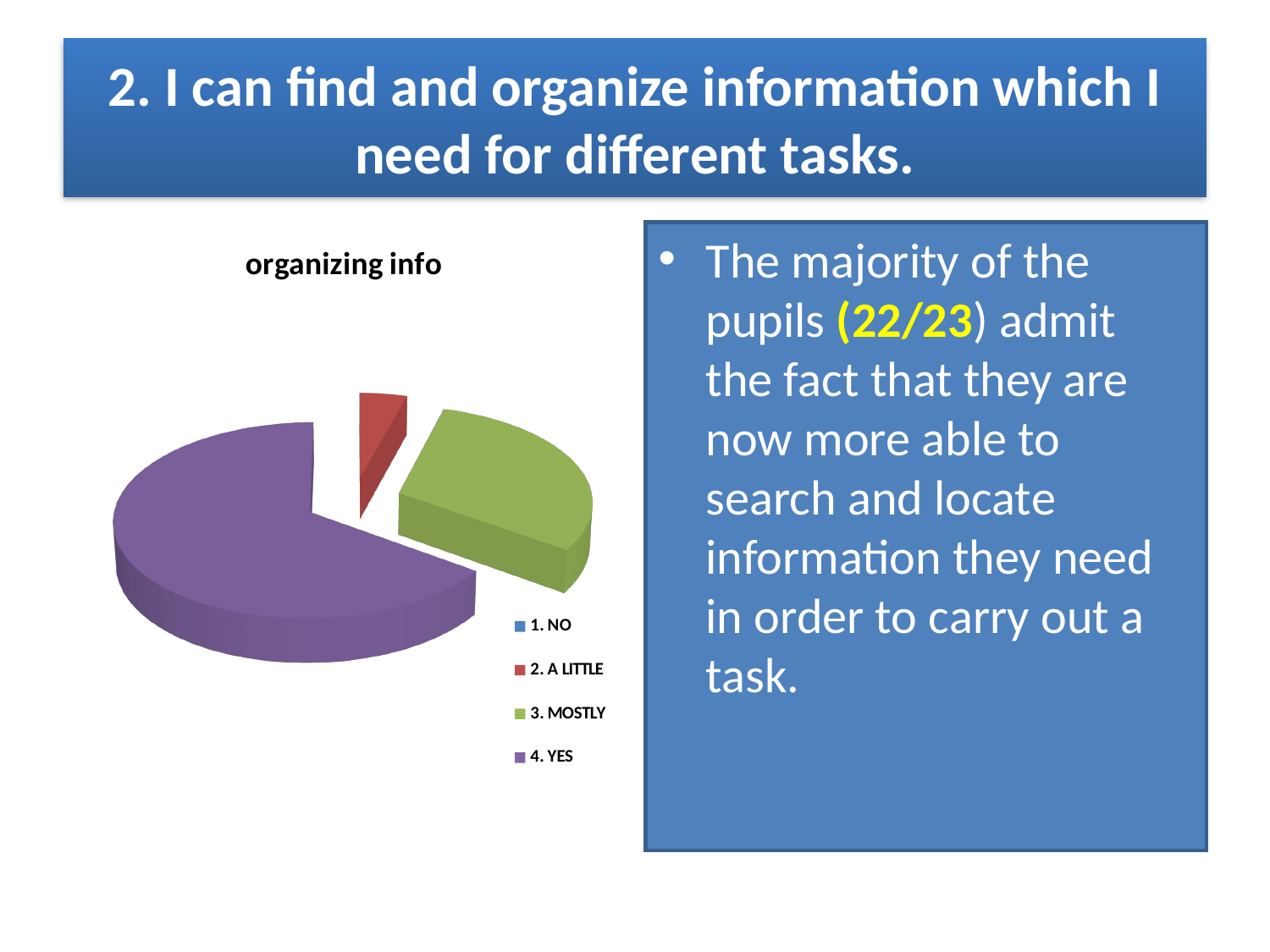
What kind of chart is shown on the slide? pie chart Does the 4. YES slice take up more or less than half of the pie? more How many categories does the chart's legend list? 4 Which category has the largest slice of the pie? 4. YES What is the title of the chart? organizing info Which slice is larger, 4. YES or 3. MOSTLY? 4. YES Which slice is larger, 3. MOSTLY or 2. A LITTLE? 3. MOSTLY Which slice is smaller, 2. A LITTLE or 4. YES? 2. A LITTLE Which colour represents the 4. YES category in the chart? purple